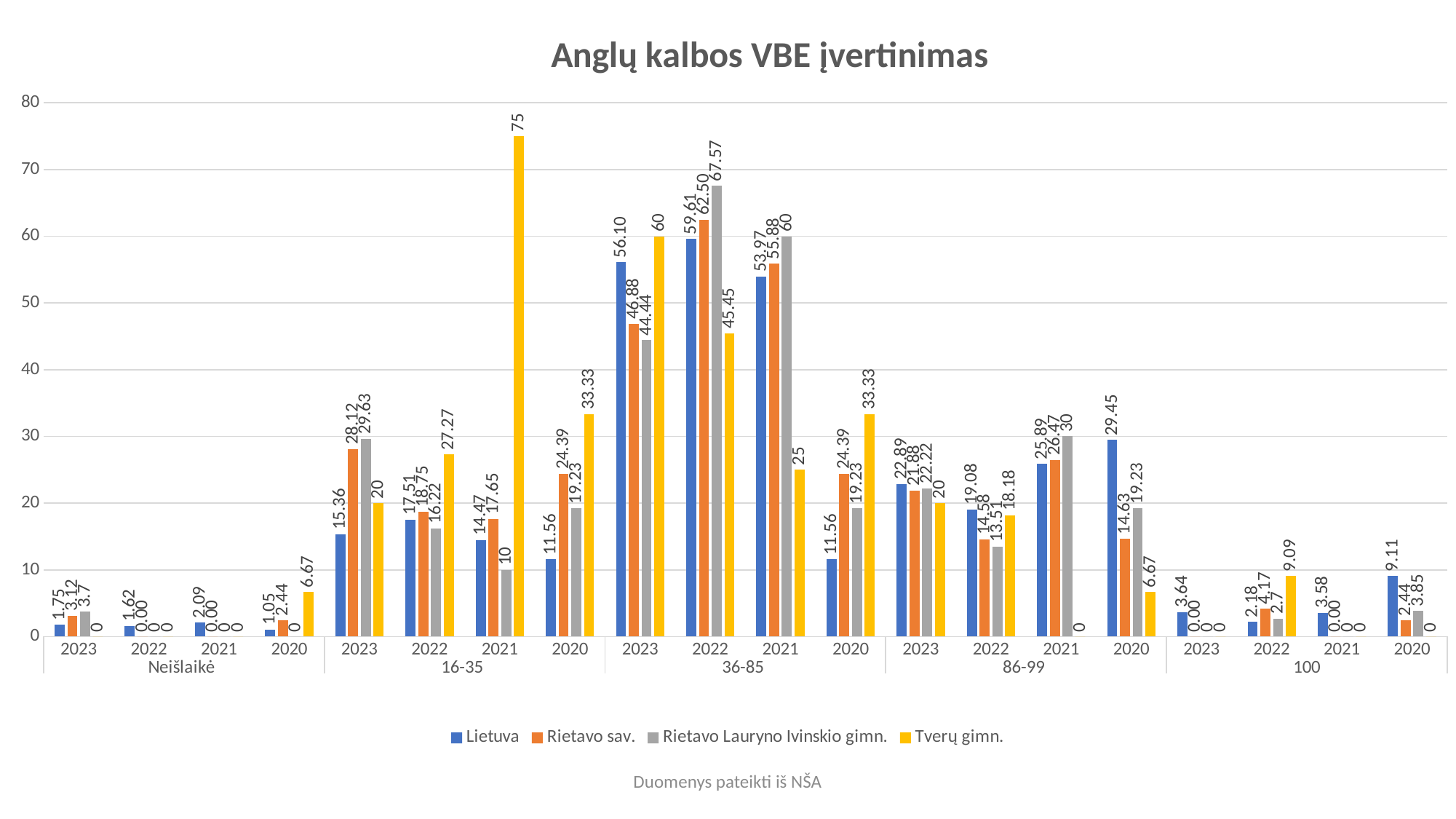
What is the value for Rietavo Lauryno Ivinskio gimn. in 2022 in the 36-85 group? 67.57 Which series has the lowest value in 2021 in the 36-85 group? Tverų gimn. What is the title of the chart? Anglų kalbos VBE įvertinimas What is the value for Rietavo sav. in 2020 in the 16-35 group? 24.39 What is the value for Lietuva in 2023 in the 36-85 group? 56.10 What is the difference between the Rietavo Lauryno Ivinskio gimn. value and the Lietuva value in 2022 in the 36-85 group? 7.96 What kind of chart is shown on the slide? Bar chart Which series has the highest value in 2021 in the 16-35 group? Tverų gimn. What is the value for Tverų gimn. in 2021 in the 16-35 group? 75 How many series does the legend list? 4 Is the value for Tverų gimn. in 2023 in the 36-85 group greater or less than 50? greater In 2020 in the 86-99 group, which is larger: the value for Lietuva or the value for Rietavo sav.? Lietuva